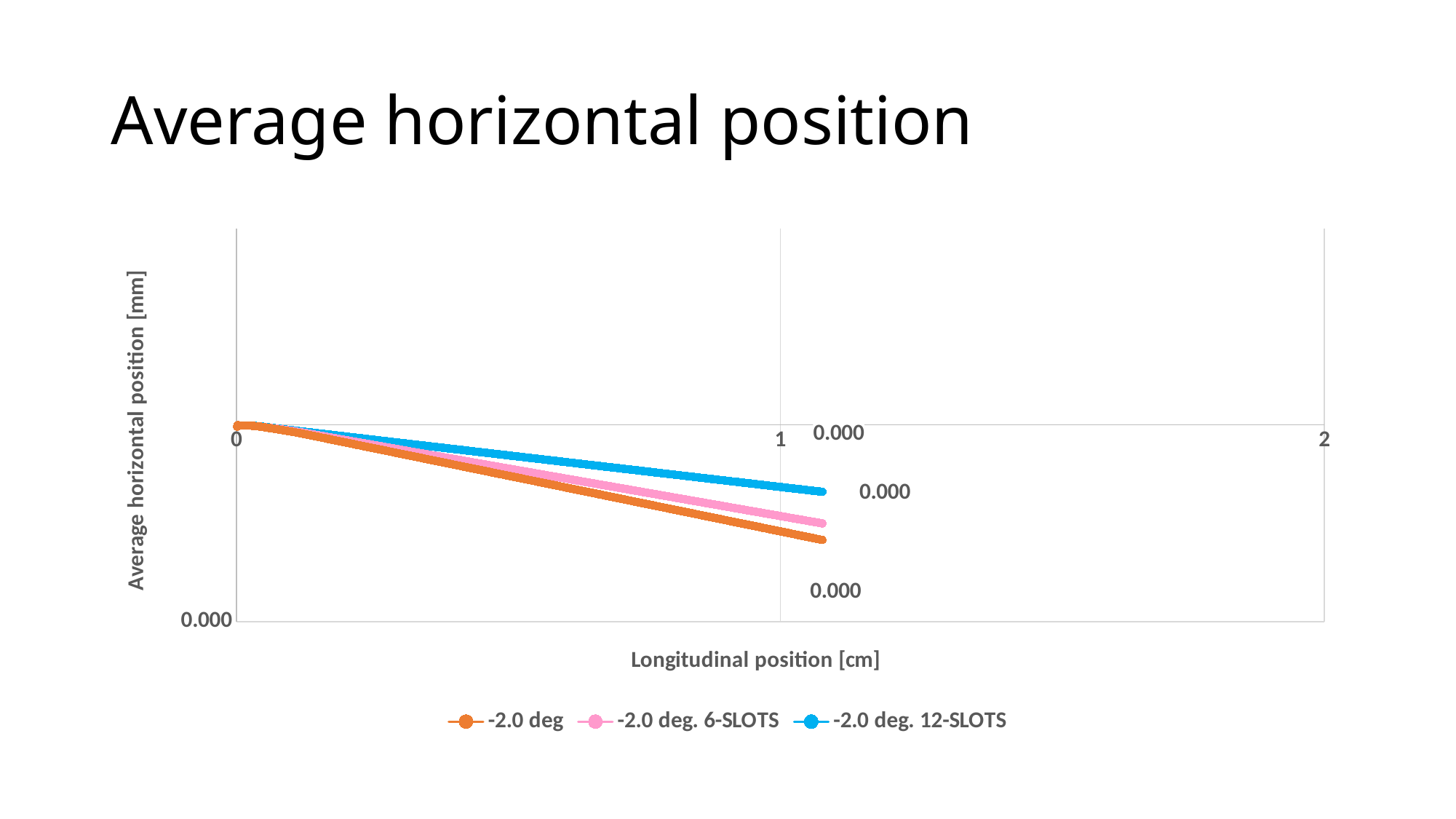
Which series has the highest value at the right end of the lines? -2.0 deg. 12-SLOTS Which series has the lowest value at the right end of the lines? -2.0 deg Do the values of the -2.0 deg series rise or fall as longitudinal position increases? fall How many series does the legend list? 3 At the right end of the lines, is the value for -2.0 deg. 6-SLOTS larger or smaller than the value for -2.0 deg. 12-SLOTS? smaller What is the label of the x axis? Longitudinal position [cm] Which series falls most steeply along the x axis? -2.0 deg Do the values of the -2.0 deg. 12-SLOTS series rise or fall along the x axis? fall At the right end of the lines, which is larger: the value for -2.0 deg. 6-SLOTS or the value for -2.0 deg? -2.0 deg. 6-SLOTS What kind of chart is shown on the slide? line chart What is the title of the chart on the slide? Average horizontal position